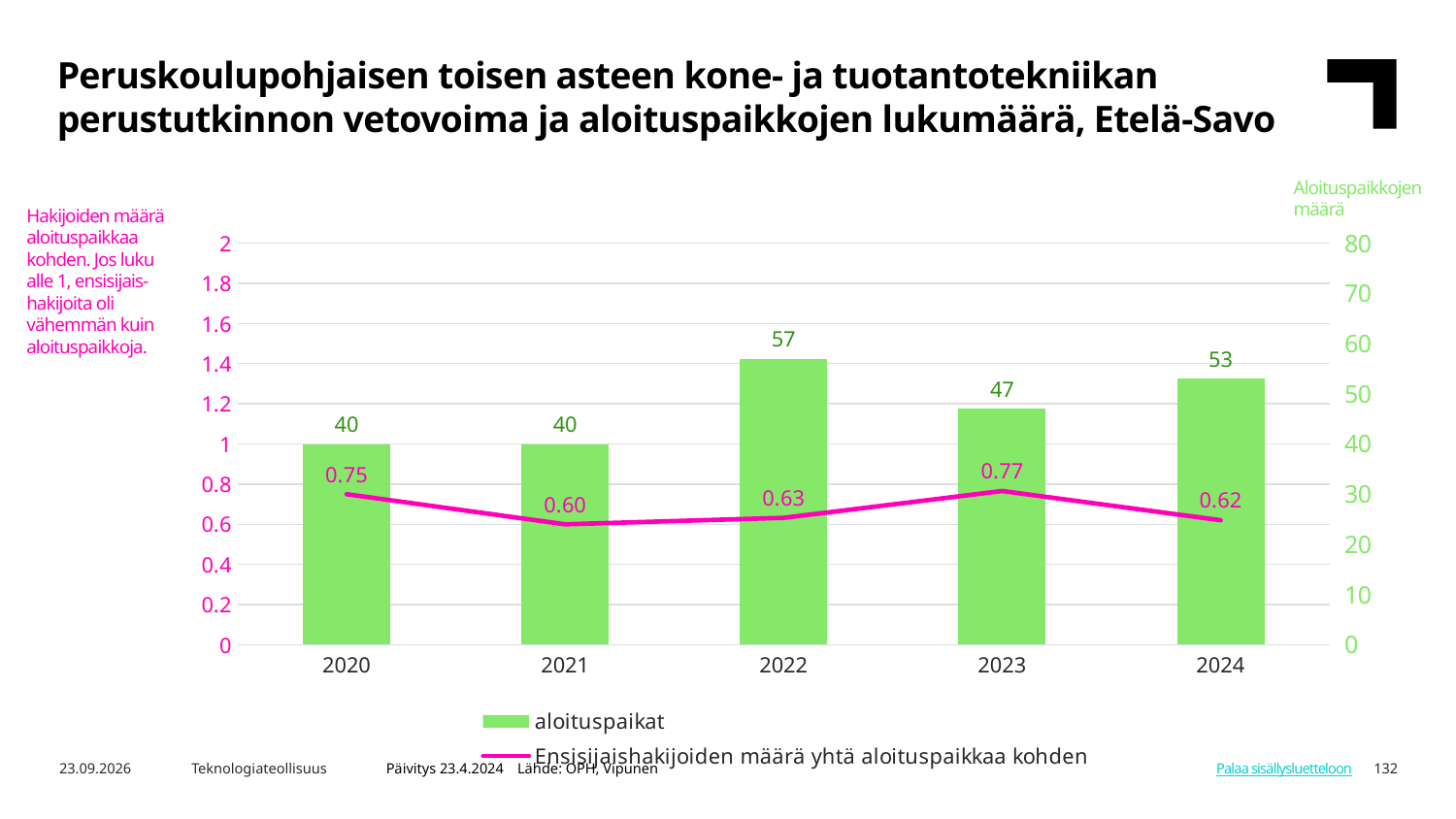
Which year has the lowest value of Ensisijaishakijoiden määrä yhtä aloituspaikkaa kohden? 2021 Which year has a larger value of aloituspaikat, 2023 or 2024? 2024 What is the value of aloituspaikat for 2022? 57 Which year has the highest value of aloituspaikat? 2022 How many years are shown on the x axis? 5 How many series does the legend list? 2 What is the difference in aloituspaikat between 2022 and 2023? 10 What is the value of Ensisijaishakijoiden määrä yhtä aloituspaikkaa kohden for 2023? 0.77 What kind of chart is used for the aloituspaikat series? bar chart Does the value of aloituspaikat rise or fall from 2021 to 2022? rise What colour are the aloituspaikat bars? green What is the value of aloituspaikat for 2024? 53